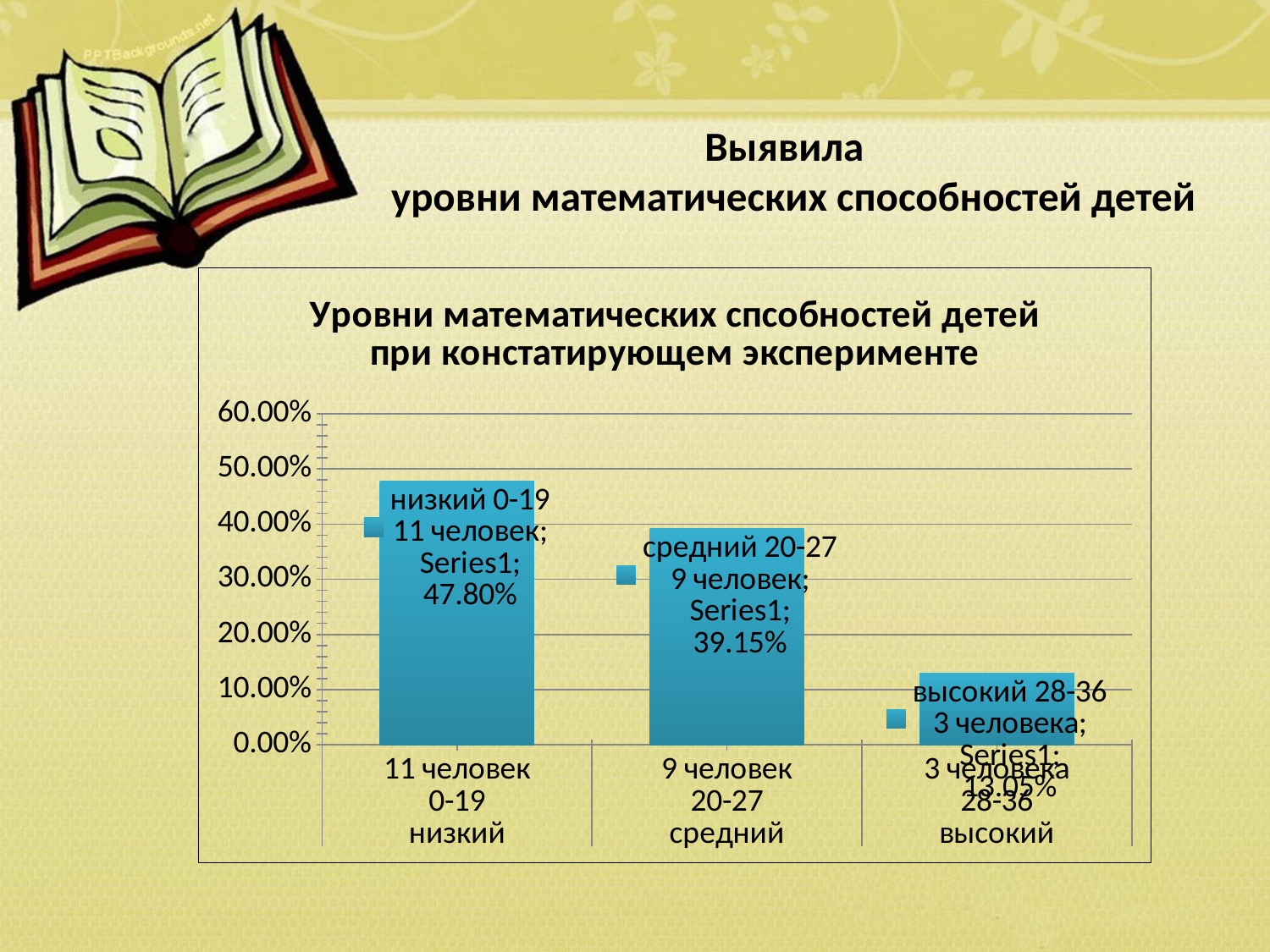
Which category has the highest value? низкий What is the difference between the values for низкий and средний? 8.65% How many categories are shown in the chart? 3 What kind of chart is shown on the slide? bar chart How many children are in the средний category according to the axis label? 9 человек What is the value for the высокий (28-36) category? 13.05% Which category has the lowest value? высокий What is the value for the низкий (0-19) category? 47.80% Is the value for высокий greater or less than 20.00%? less Do the values rise or fall from left to right along the x axis? fall What is the value for the средний (20-27) category? 39.15% Which is larger, the value for средний or the value for высокий? средний